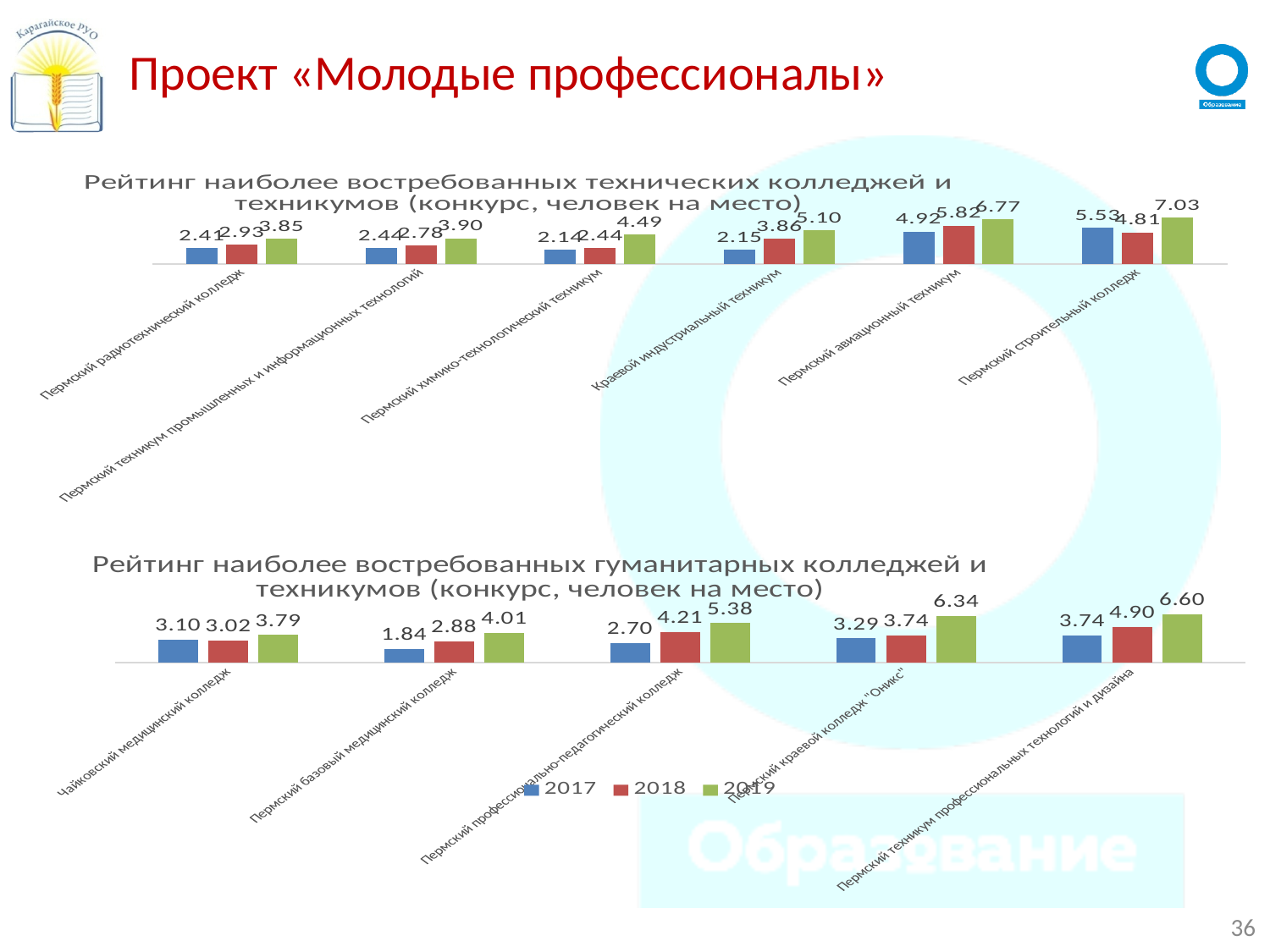
In the top chart (technical colleges), how many colleges are shown? 6 In the top chart (technical colleges), what is the difference between the 2019 and 2017 values for Краевой индустриальный техникум? 2.95 In the bottom chart (humanitarian colleges), which is larger: the 2018 value for Чайковский медицинский колледж or the 2018 value for Пермский профессионально-педагогический колледж? Пермский профессионально-педагогический колледж What type of chart is the bottom chart (humanitarian colleges)? bar chart How many series does the legend list? 3 In the bottom chart (humanitarian colleges), what is the difference between the 2019 and 2018 values for Пермский техникум профессиональных технологий и дизайна? 1.70 In the top chart (technical colleges), do the values for Пермский химико-технологический техникум rise or fall from 2017 to 2019? rise In the bottom chart (humanitarian colleges), what is the 2019 value for Пермский краевой колледж "Оникс"? 6.34 In the top chart (technical colleges), what is the 2019 value for Пермский строительный колледж? 7.03 In the top chart (technical colleges), which college has the highest 2019 value? Пермский строительный колледж In the bottom chart (humanitarian colleges), which college has the lowest 2017 value? Пермский базовый медицинский колледж In the top chart (technical colleges), what is the 2017 value for Пермский авиационный техникум? 4.92